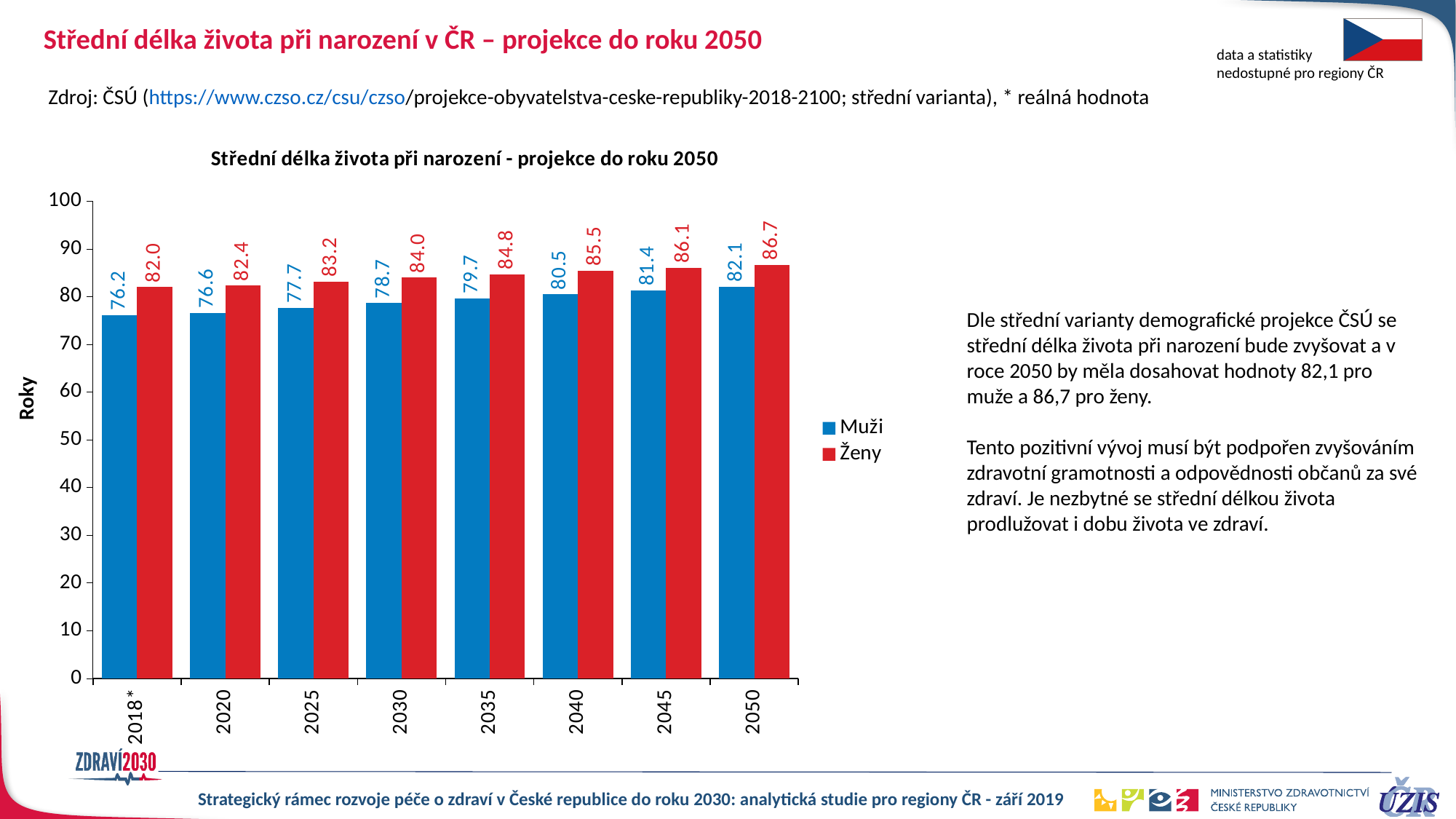
In which year is the Muži value lowest? 2018* Do the Muži values rise or fall from 2018* to 2050? rise What is the difference between the Ženy and Muži values in 2050? 4.6 How many series does the legend list? 2 How many years are shown on the x axis? 8 What kind of chart is shown? bar chart What is the value for Ženy in 2018*? 82.0 Which is larger in 2040, the Muži value or the Ženy value? Ženy What is the value for Ženy in 2035? 84.8 What is the value for Muži in 2050? 82.1 In which year is the Ženy value highest? 2050 What is the value for Muži in 2030? 78.7